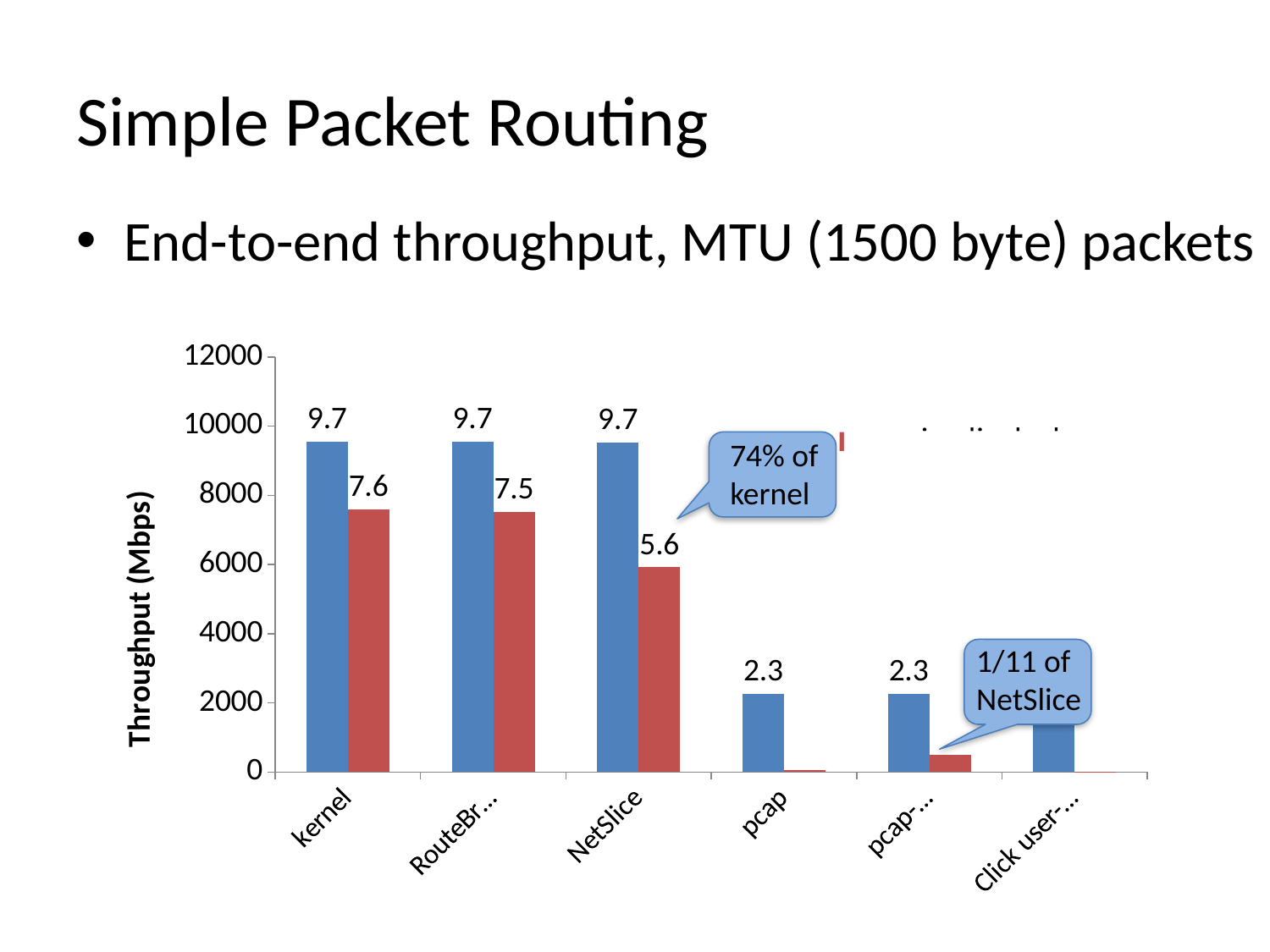
Which category has the highest red bar? kernel Is the red bar for NetSlice greater or less than 4000 on the y axis? greater What is the data label on the red bar for NetSlice? 5.6 What is the data label on the blue bar for pcap? 2.3 Which red bar is larger, kernel or NetSlice? kernel What is the difference between the red bar labels for kernel (7.6) and NetSlice (5.6)? 2.0 What is the y-axis title of the chart? Throughput (Mbps) Is the blue bar for pcap greater or less than 4000 on the y axis? less What is the data label on the red bar for kernel? 7.6 How many categories are shown along the x axis of the chart? 6 What kind of chart is shown on the slide? bar chart What is the data label on the blue bar for kernel? 9.7